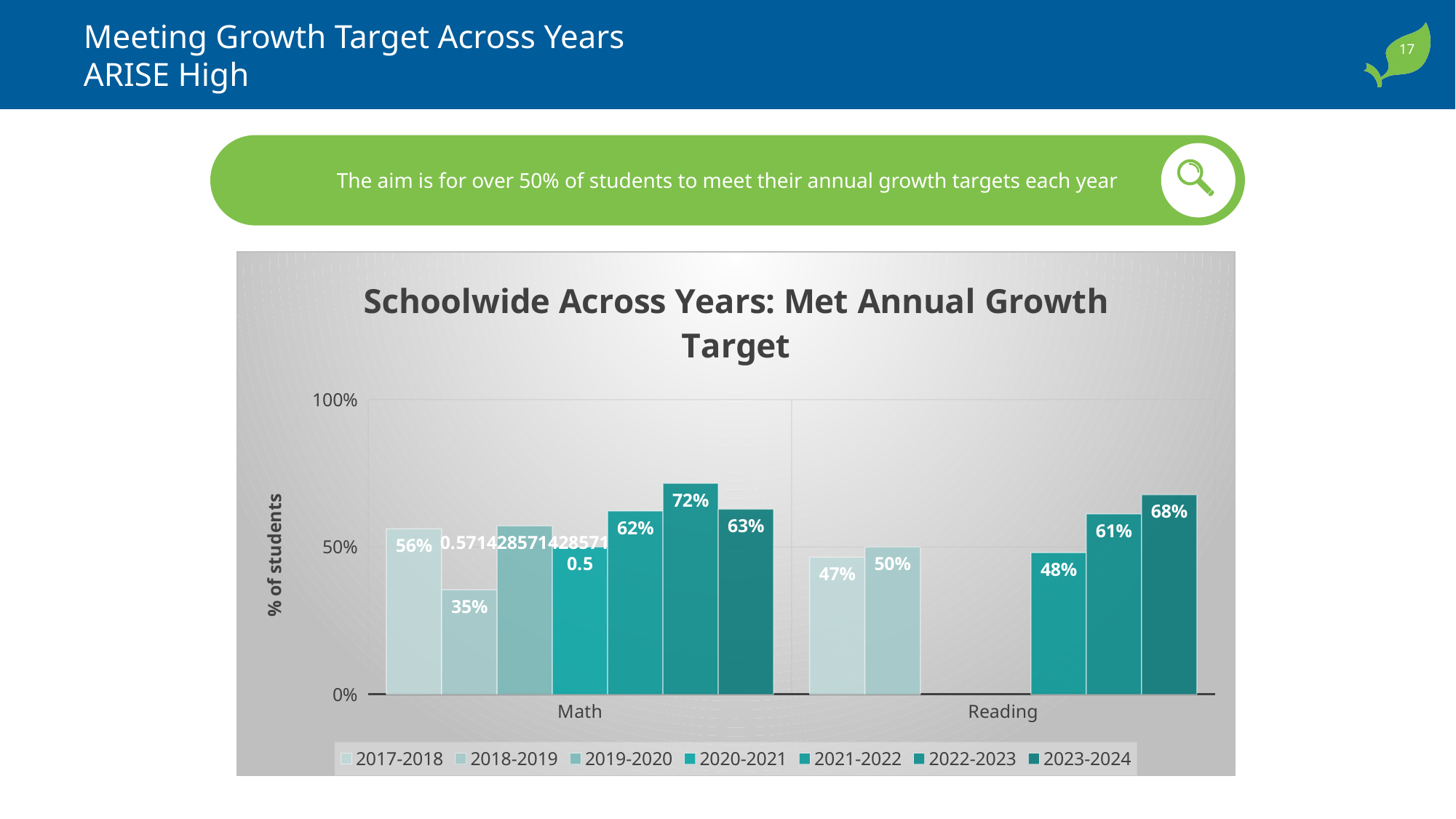
What is the value for Reading in 2017-2018? 47% What is the difference between the Reading values for 2023-2024 and 2021-2022? 20 percentage points How many series does the legend list? 7 What is the label of the vertical axis? % of students What percentage of students met their annual growth target in Math in 2022-2023? 72% Which is larger for Reading: the 2022-2023 value or the 2023-2024 value? 2023-2024 Which year has the highest value for Math? 2022-2023 What kind of chart is shown on the slide? Bar chart What is the difference between the Math values for 2022-2023 and 2023-2024? 9 percentage points What is the value for Math in 2018-2019? 35% Which year has the lowest value for Math? 2018-2019 What is the value for Reading in 2023-2024? 68%